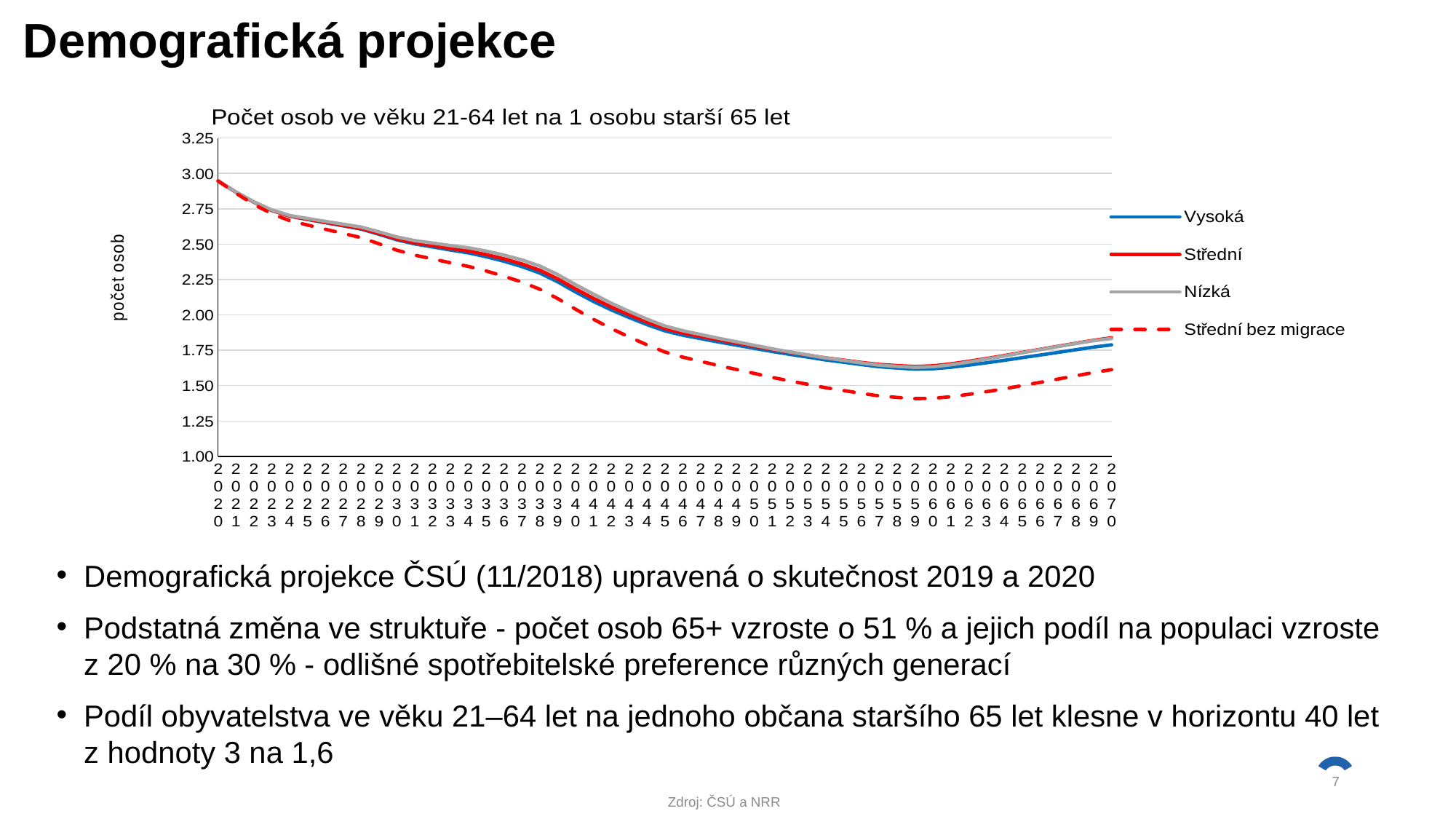
Which series has the lowest value in 2060? Střední bez migrace In 2050, which is larger: the value for Střední or the value for Střední bez migrace? Střední Do the values of the Střední series rise or fall between 2020 and 2060? fall What is the last year shown on the x axis? 2070 How many series does the legend list? 4 What is the title of the chart? Počet osob ve věku 21-64 let na 1 osobu starší 65 let What is the first year shown on the x axis? 2020 Is the value for Střední bez migrace in 2060 greater or less than 1.50? less Is the value for Vysoká in 2020 greater or less than 2.75? greater What kind of chart is shown on the slide? line chart Is the value for Střední bez migrace in 2070 greater or less than 1.75? less Which series is drawn as a dashed line? Střední bez migrace